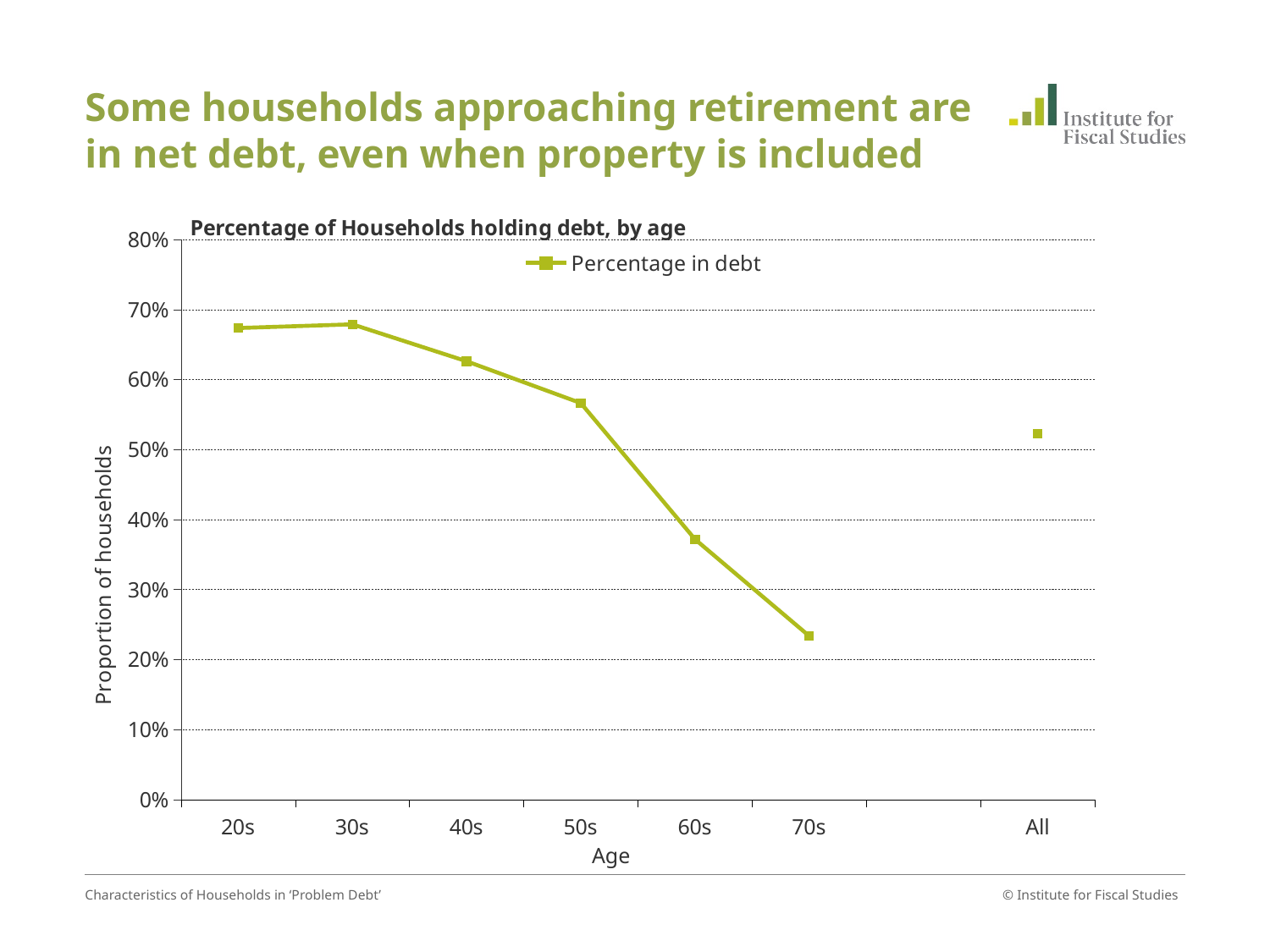
Is the percentage in debt for the 70s age group greater or less than 30%? less Which has a higher percentage in debt, the 50s age group or the 60s age group? 50s What is the label of the y axis? Proportion of households Does the percentage in debt rise or fall as age increases from the 30s to the 70s? Falls Is the percentage in debt for the 40s age group greater or less than 60%? greater Is the percentage in debt for the 'All' category greater or less than 60%? less Which age group has the lowest percentage in debt? 70s How many series does the legend list? 1 How many age categories are shown on the x axis? 7 What kind of chart is shown on the slide? Line chart What is the title of the chart? Percentage of Households holding debt, by age